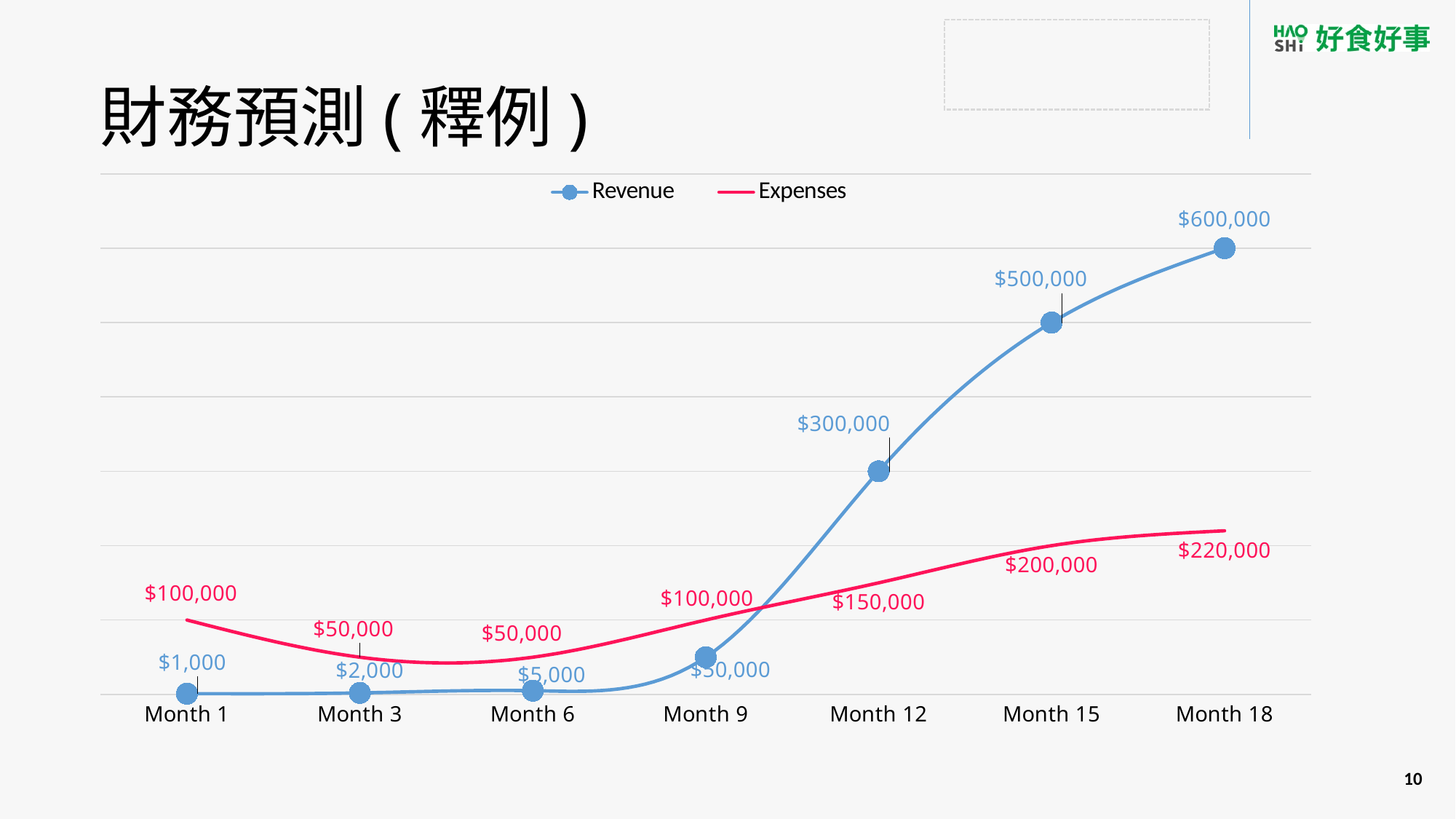
What is the Expenses value at Month 12? $150,000 What is the difference between Revenue and Expenses at Month 18? $380,000 How many months are shown on the x axis? 7 What kind of chart is shown on the slide? Line chart At which month is Revenue lowest? Month 1 At which month is Revenue highest? Month 18 What is the Revenue value at Month 18? $600,000 At Month 12, which is larger, Revenue or Expenses? Revenue What is the Revenue value at Month 1? $1,000 How many series does the legend list? 2 At Month 9, which is larger, Revenue or Expenses? Expenses What is the Expenses value at Month 18? $220,000